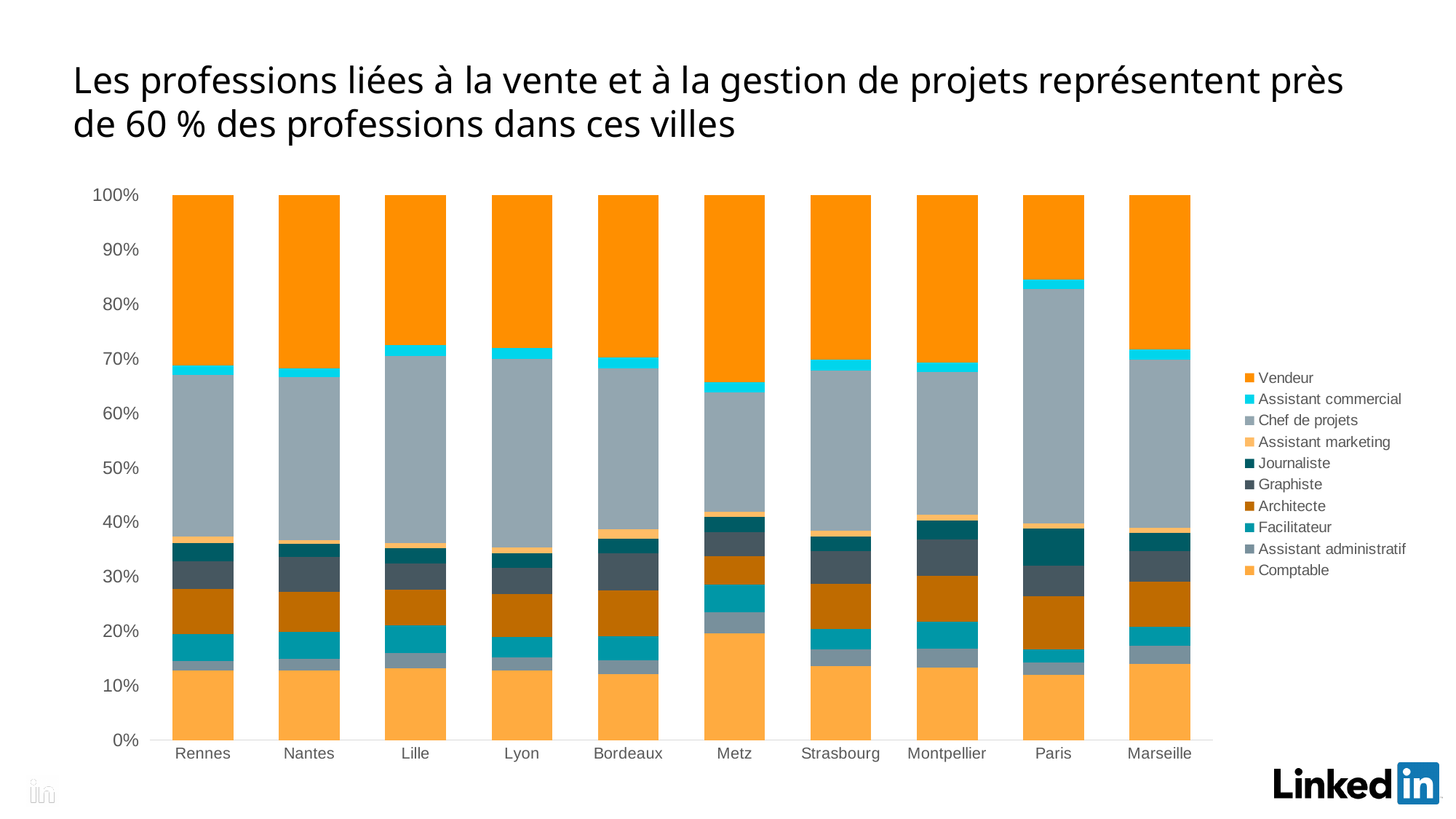
Which city has the largest Comptable segment? Metz Is the share of Comptable in Metz greater or less than 15%? greater Which city has the largest Chef de projets segment? Paris How many cities are shown on the x axis of the chart? 10 Is the Vendeur segment larger for Metz or for Paris? Metz Which city has the smallest Vendeur segment? Paris Is the share of Vendeur in Paris greater or less than 20%? less How many series does the legend list? 10 Which series is listed first in the legend? Vendeur Which city has the smallest Chef de projets segment? Metz What kind of chart is shown on the slide? Stacked bar chart Is the share of Chef de projets in Paris greater or less than 40%? greater